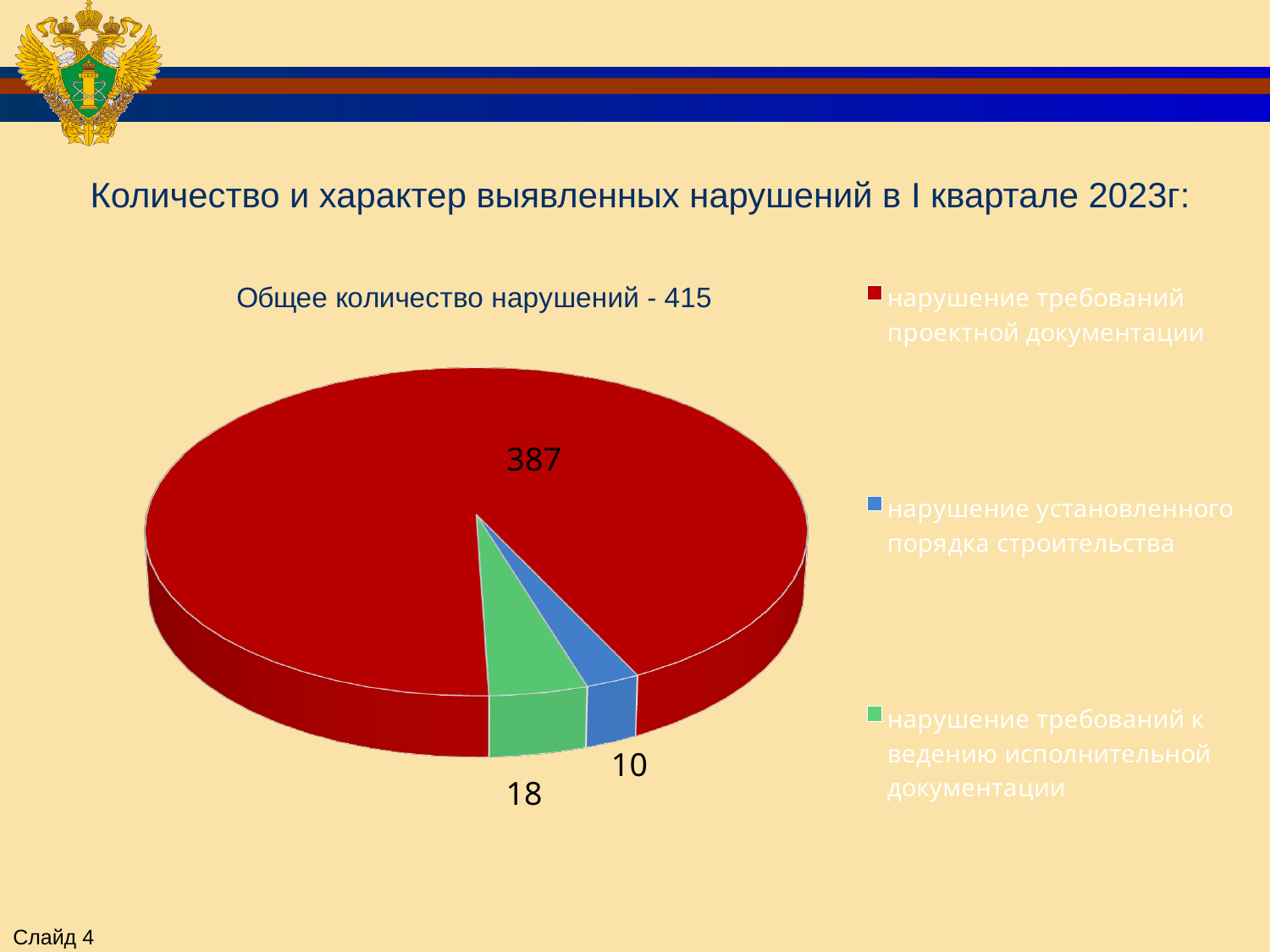
How many entries does the legend list? 3 How many slices does the pie chart have? 3 What is the value for 'нарушение установленного порядка строительства'? 10 Which category has the smallest slice of the pie? нарушение установленного порядка строительства What is the difference between the values for 'нарушение требований к ведению исполнительной документации' and 'нарушение установленного порядка строительства'? 8 Which is larger: the value for 'нарушение требований к ведению исполнительной документации' or for 'нарушение установленного порядка строительства'? нарушение требований к ведению исполнительной документации What type of chart is shown on the slide? pie chart What is the value for 'нарушение требований к ведению исполнительной документации'? 18 What is the value for 'нарушение требований проектной документации'? 387 Which category has the largest slice of the pie? нарушение требований проектной документации What total number of violations is stated in the chart title? 415 What is the difference between the values for 'нарушение требований проектной документации' and 'нарушение требований к ведению исполнительной документации'? 369